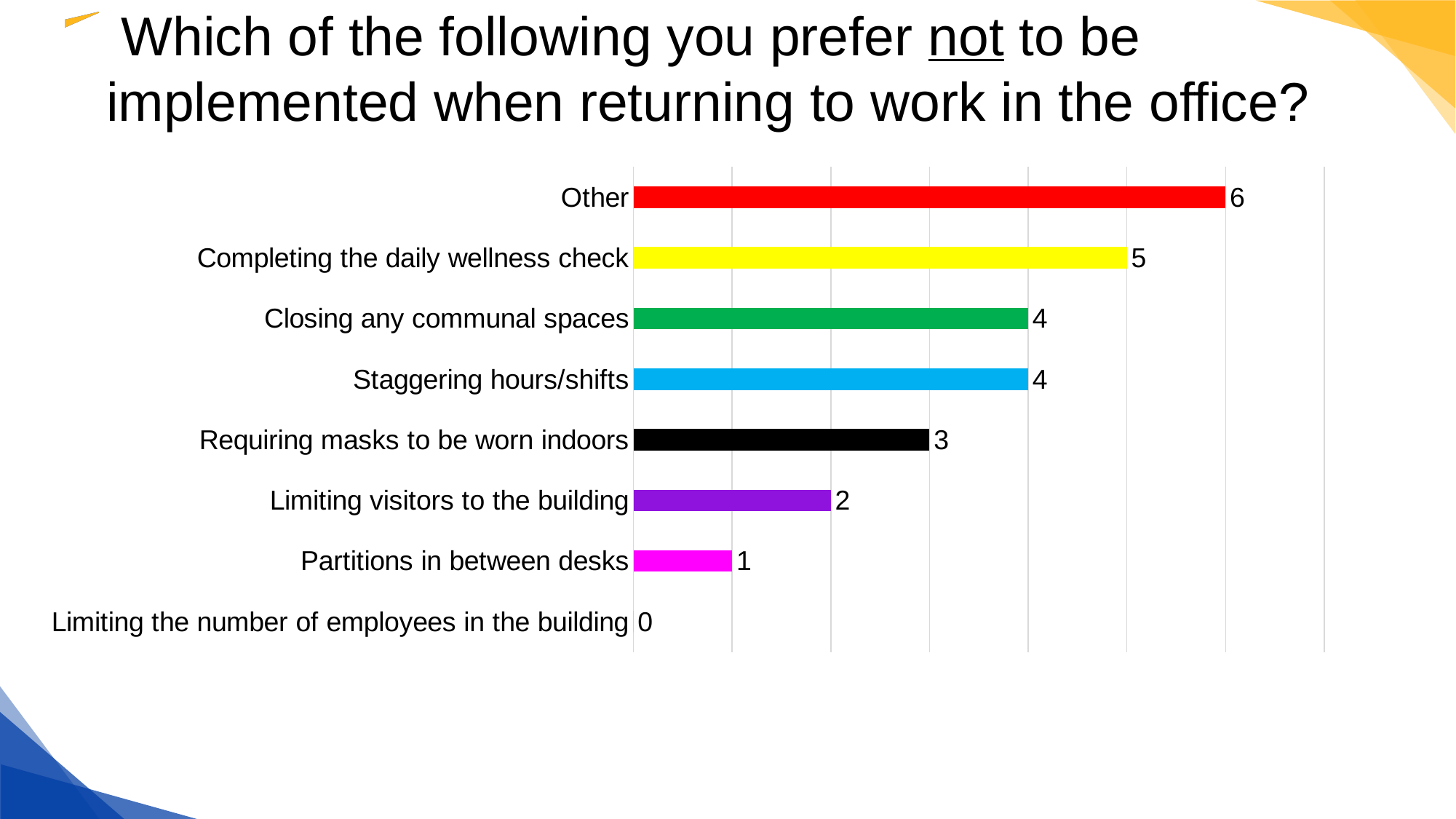
What is the value for "Requiring masks to be worn indoors"? 3 Which two categories both have a value of 4? Closing any communal spaces and Staggering hours/shifts What is the value for "Limiting the number of employees in the building"? 0 What colour is the bar for "Staggering hours/shifts"? Light blue What kind of chart is shown on the slide? Bar chart What is the difference between the values for "Other" and "Partitions in between desks"? 5 What is the value for "Other"? 6 Which is larger, the value for "Limiting visitors to the building" or the value for "Requiring masks to be worn indoors"? Requiring masks to be worn indoors Which category has the highest value? Other Which category has the lowest value? Limiting the number of employees in the building What is the value for "Completing the daily wellness check"? 5 How many categories are shown in the chart? 8